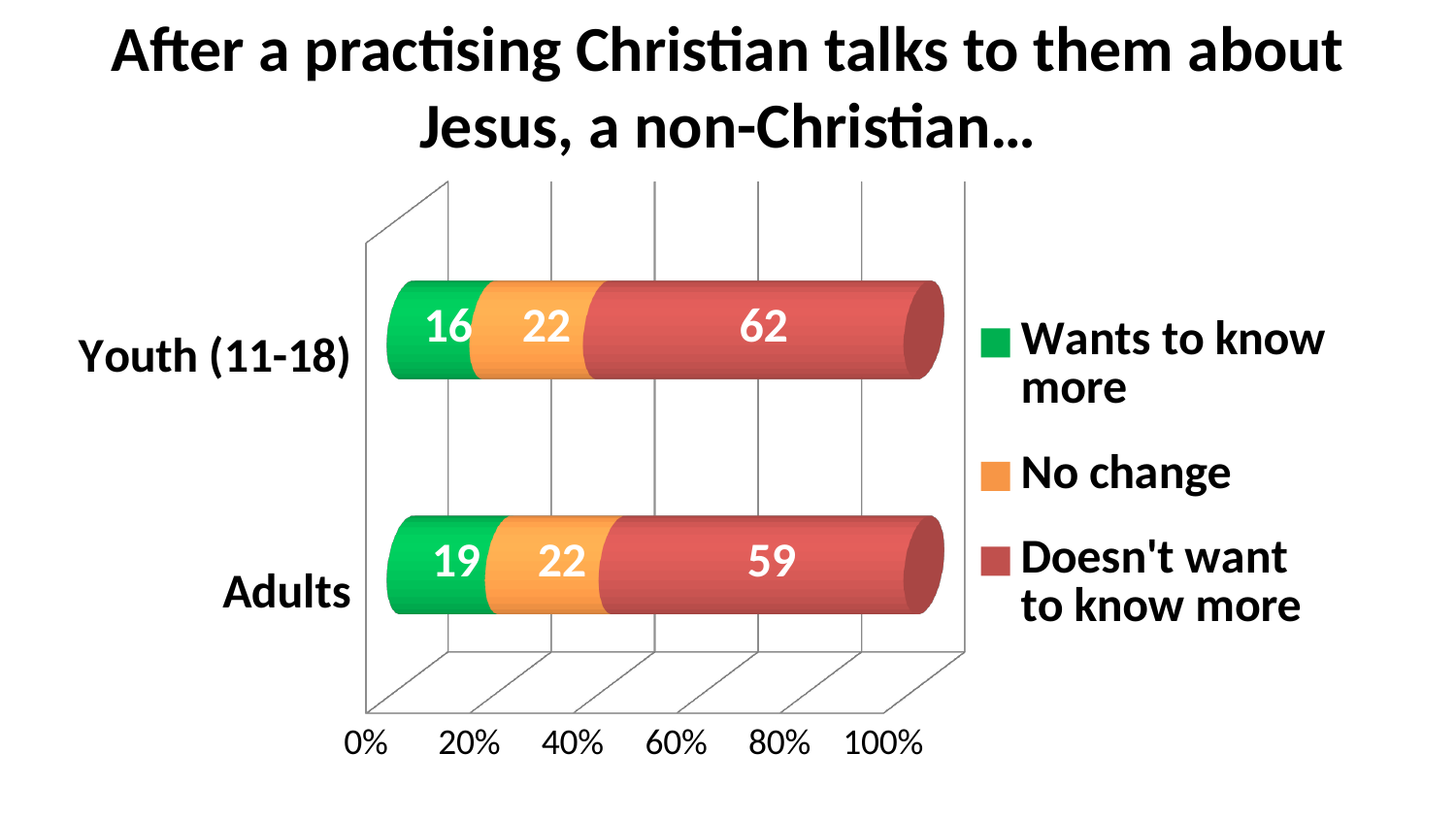
What is the difference between the "Wants to know more" values for Adults and Youth (11-18)? 3 What is the value for "Wants to know more" for Youth (11-18)? 16 What is the difference between the "Doesn't want to know more" values for Youth (11-18) and Adults? 3 What is the value for "Doesn't want to know more" for Youth (11-18)? 62 What is the value for "Doesn't want to know more" for Adults? 59 How many categories are shown on the chart? 2 What kind of chart is shown on the slide? Stacked bar chart What is the total of the stacked bar for Youth (11-18)? 100 Which category has the higher value for "Wants to know more", Youth (11-18) or Adults? Adults How many series does the legend list? 3 What is the value for "No change" for Adults? 22 Which colour represents "No change" in the chart? Orange